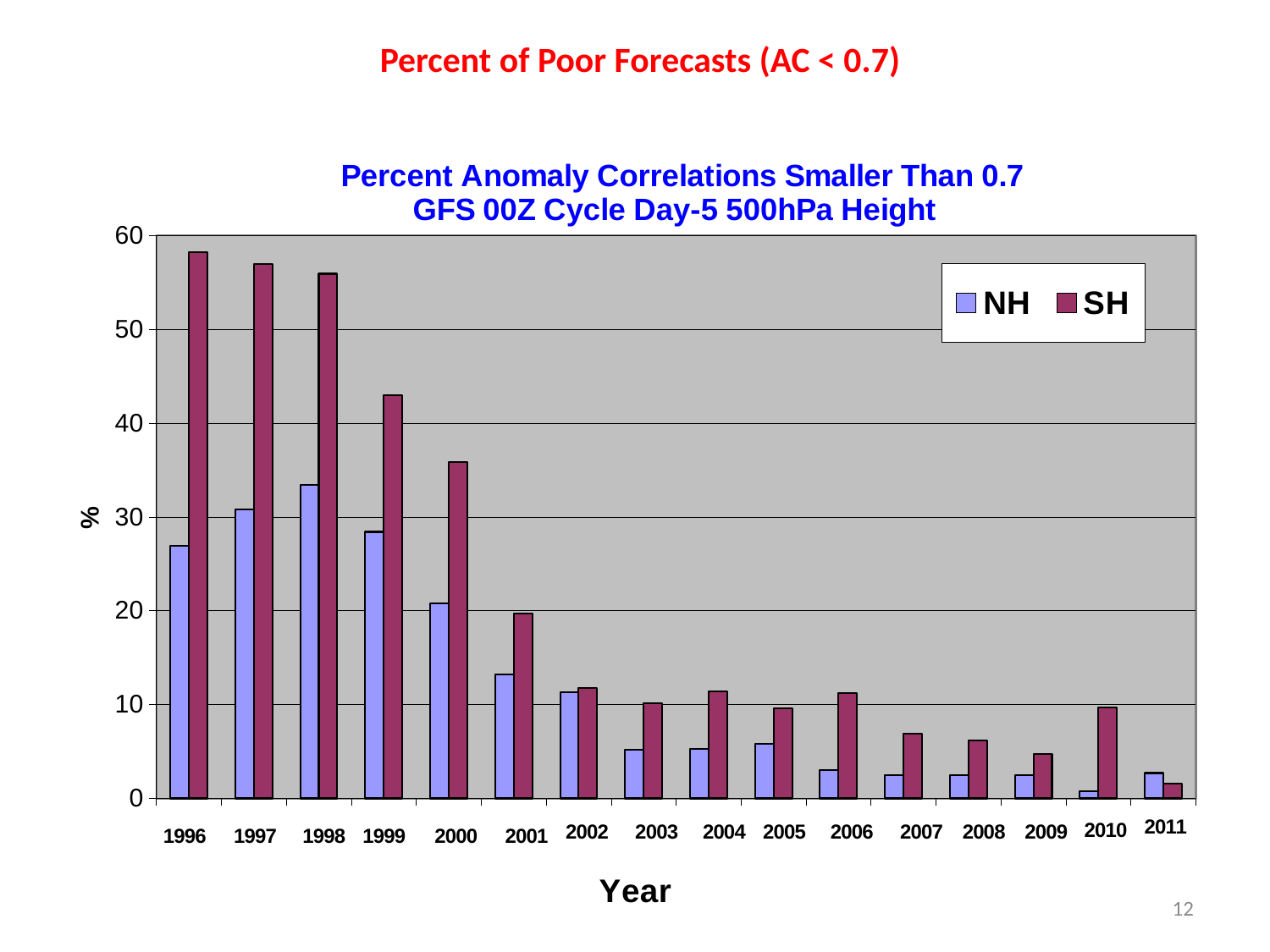
In which year is the SH value lowest? 2011 In which year is the NH value lowest? 2010 Is the NH value for 1996 greater or less than 30? less Do the SH values rise or fall from 1996 to 2001? fall In 2010, which series has the larger value, NH or SH? SH Is the SH value for 1996 greater or less than 50? greater Is the SH value for 1999 greater or less than 40? greater How many years are shown along the x axis? 16 In 2011, which series has the larger value, NH or SH? NH How many series does the legend list? 2 What kind of chart is shown on the slide? bar chart In which year is the NH value highest? 1998